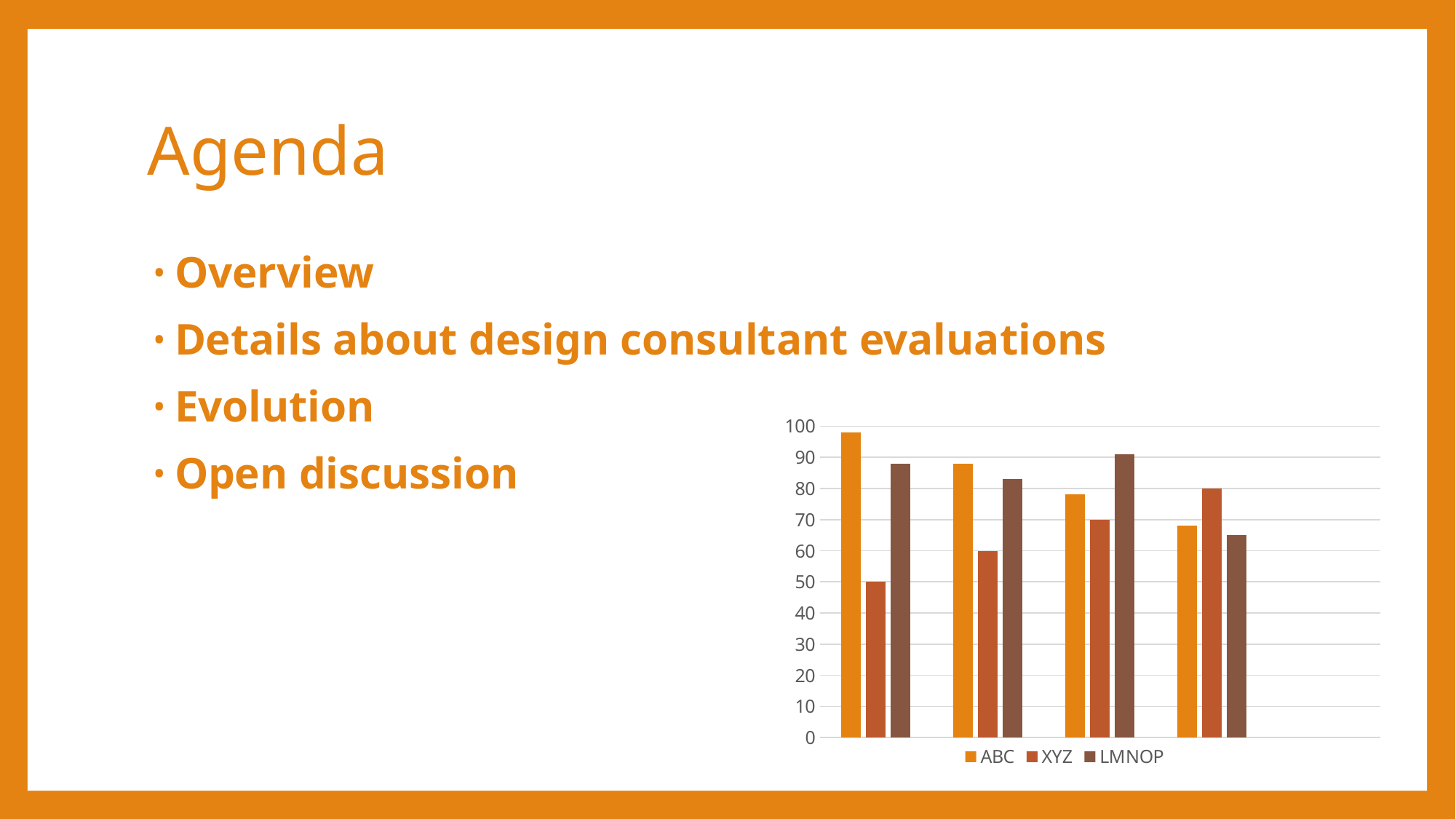
What are the three series named in the chart's legend? ABC, XYZ, LMNOP Is the value of the ABC bar in the first group greater or less than 90? greater What kind of chart is shown on the slide? bar chart Do the XYZ bars rise or fall from the first group to the fourth group? rise How many groups of bars are plotted in the chart? 4 How many series does the chart's legend list? 3 What is the value of the XYZ bar in the second group from the left? 60 In the fourth group from the left, which bar is larger, XYZ or LMNOP? XYZ What is the value of the XYZ bar in the first group from the left? 50 Which series has the lowest bar in the first group from the left? XYZ What is the difference between the XYZ bar in the fourth group and the XYZ bar in the first group? 30 What is the value of the XYZ bar in the fourth group from the left? 80